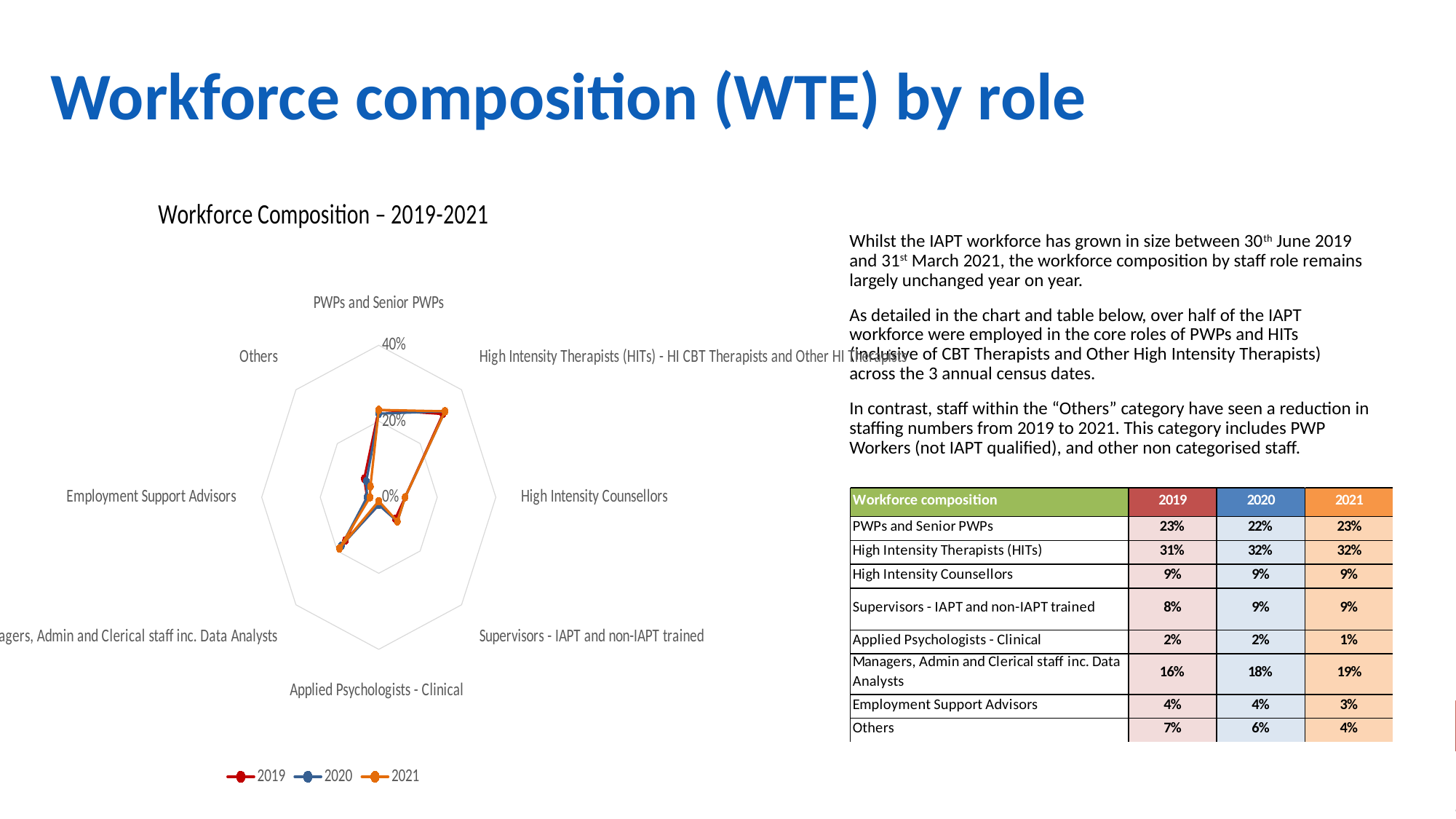
Which years are listed in the legend of the radar chart? 2019, 2020, 2021 What kind of chart is shown under the title "Workforce Composition – 2019-2021"? Radar chart How many series does the legend of the radar chart list? 3 Which role category has the highest share of the workforce in 2021? High Intensity Therapists (HITs) Is the 2021 value for High Intensity Therapists (HITs) on the radar chart greater or less than 20%? greater Which role category has the lowest share of the workforce in 2021? Applied Psychologists - Clinical According to the table, what share of the workforce were High Intensity Therapists (HITs) in 2021? 32% According to the table, what share of the workforce were PWPs and Senior PWPs in 2020? 22% In 2021, which is larger: the share for Managers, Admin and Clerical staff inc. Data Analysts or the share for High Intensity Counsellors? Managers, Admin and Clerical staff inc. Data Analysts How many role categories are plotted on the radar chart? 8 Using the table values, what is the difference between the 2019 and 2021 shares for the Others category? 3% What is the highest percentage tick shown on the radar chart's axis? 40%